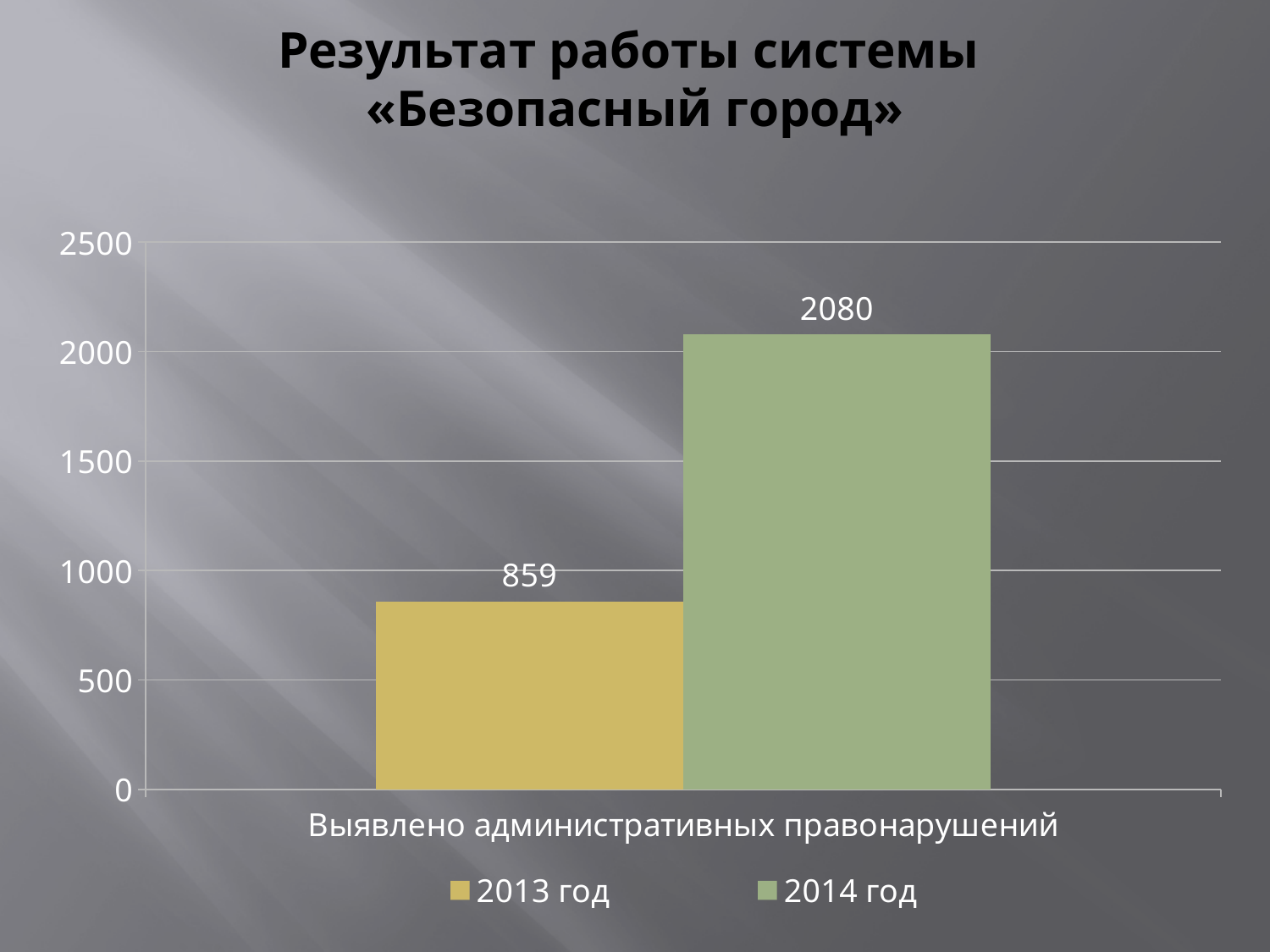
What is the title of the slide? Результат работы системы «Безопасный город» What is the difference between the 2014 год and 2013 год values? 1221 What is the category label on the x axis? Выявлено административных правонарушений Which series has the lowest value? 2013 год Is the value for 2013 год greater or less than 1000? less How many categories are shown on the x axis? 1 Which series has the higher value, 2013 год or 2014 год? 2014 год Is the value for 2014 год greater or less than 2000? greater How many series does the legend list? 2 What kind of chart is shown on the slide? bar chart What is the value for 2013 год? 859 What is the value for 2014 год? 2080